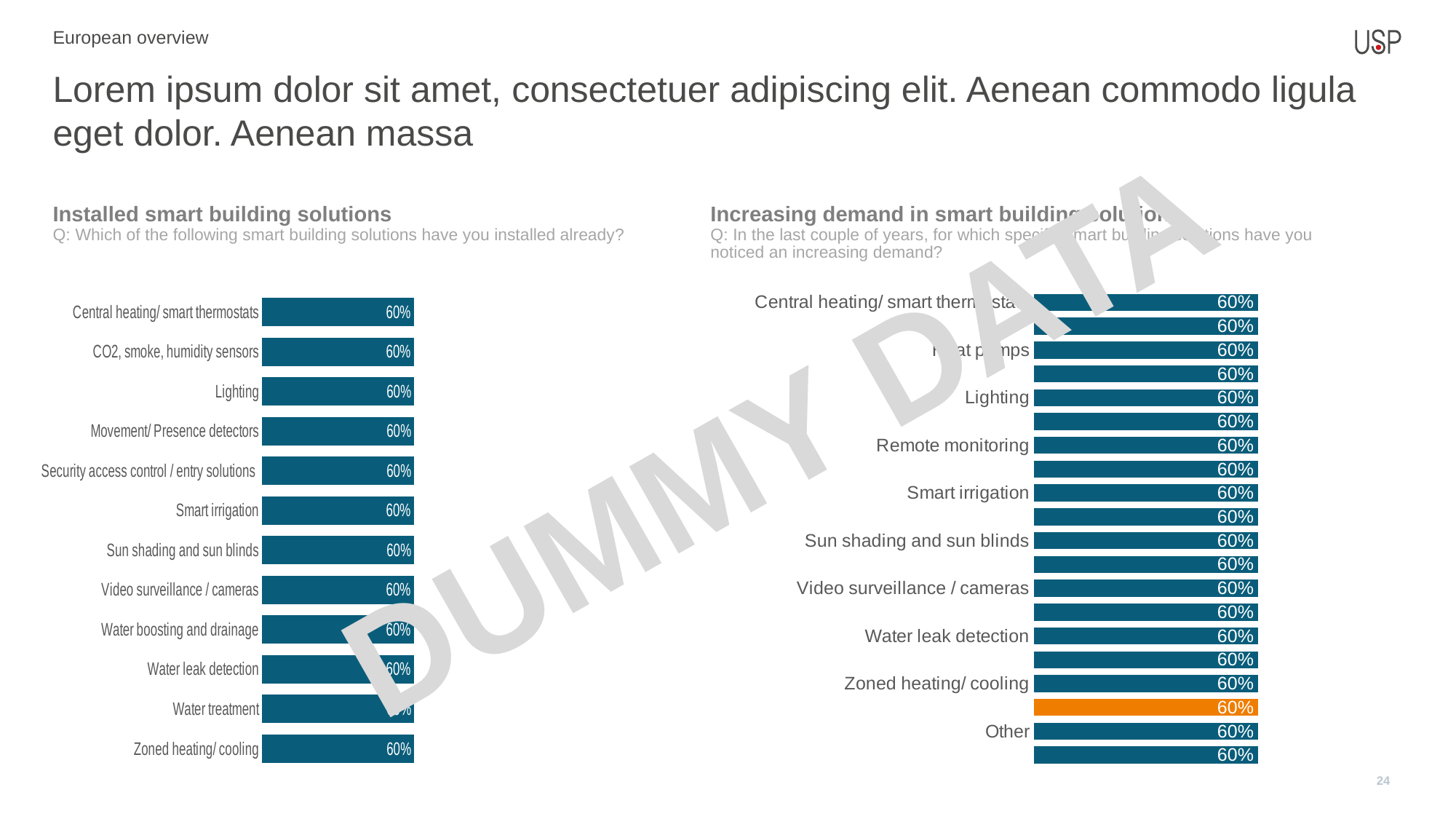
On the 'Increasing demand in smart building solutions' chart, how many category labels are shown on the axis? 10 On the 'Installed smart building solutions' chart, what is the value for Lighting? 60% On the 'Installed smart building solutions' chart, what is the difference between the values for Lighting and Smart irrigation? 0% On the 'Installed smart building solutions' chart, how many categories are plotted? 12 On the 'Installed smart building solutions' chart, what is the value for Security access control / entry solutions? 60% On the 'Increasing demand in smart building solutions' chart, how many bars are plotted in total? 20 On the 'Increasing demand in smart building solutions' chart, what value is shown on the orange bar? 60% On the 'Installed smart building solutions' chart, what is the value for Zoned heating/ cooling? 60% On the 'Increasing demand in smart building solutions' chart, what value is shown on the bar next to Remote monitoring? 60% What kind of chart is the 'Installed smart building solutions' chart? Bar chart On the 'Increasing demand in smart building solutions' chart, which category label is listed last at the bottom? Other On the 'Increasing demand in smart building solutions' chart, how many bars are coloured orange? 1